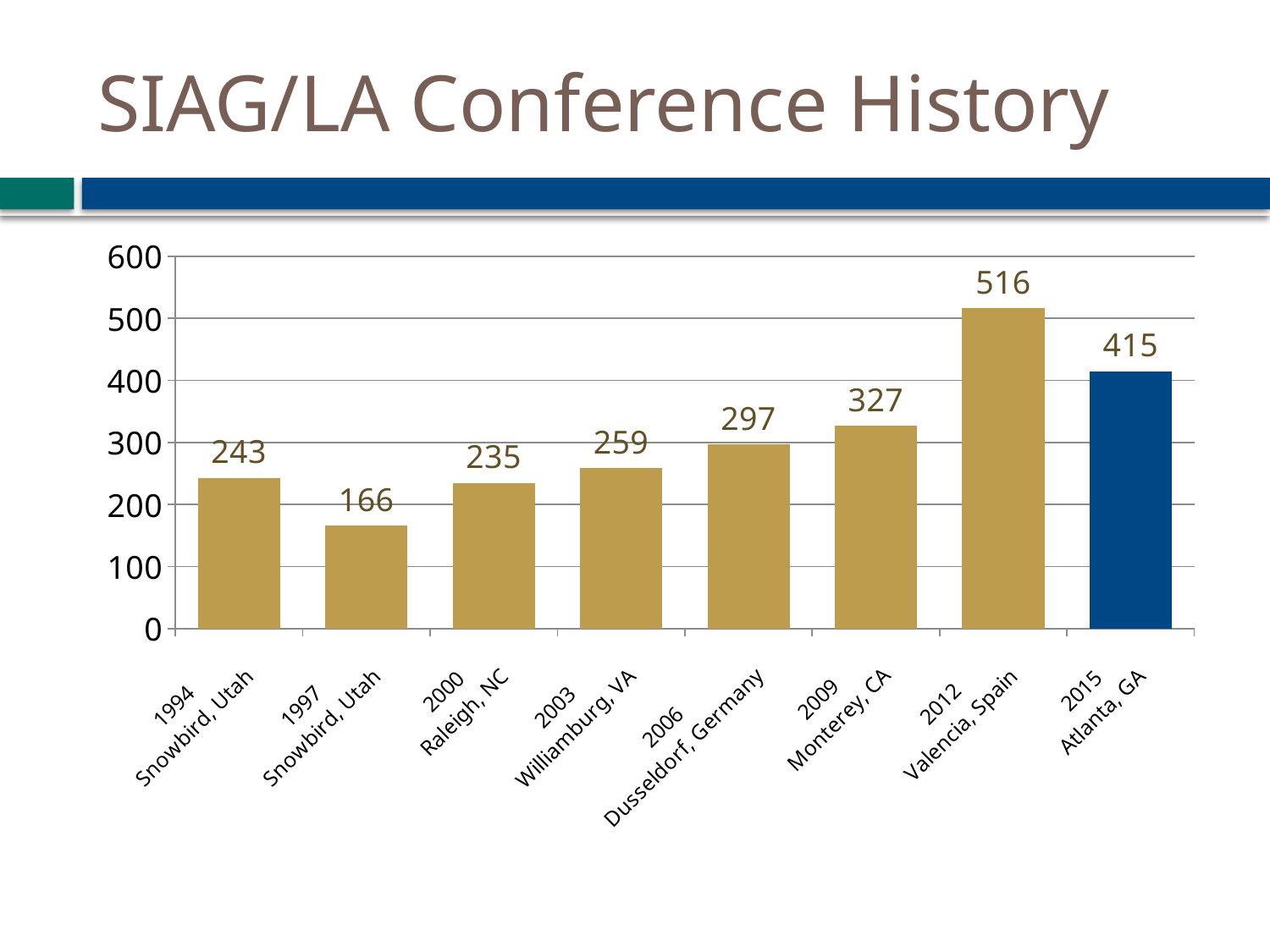
Which conference has the lowest value? 1997 Snowbird, Utah Which is larger, the value for 2003 Williamsburg, VA or the value for 2009 Monterey, CA? 2009 Monterey, CA Which conference has the highest value? 2012 Valencia, Spain What is the difference between the values for 1994 Snowbird, Utah and 2000 Raleigh, NC? 8 What is the value for 2006 Dusseldorf, Germany? 297 What kind of chart is shown on the slide? bar chart How many conferences are shown in the chart? 8 Is the value for 2015 Atlanta, GA greater or less than 400? greater Which bar is shown in a different colour from the others? 2015 Atlanta, GA What is the value for 2012 Valencia, Spain? 516 What is the difference between the values for 2012 Valencia, Spain and 2015 Atlanta, GA? 101 What is the value for 1997 Snowbird, Utah? 166